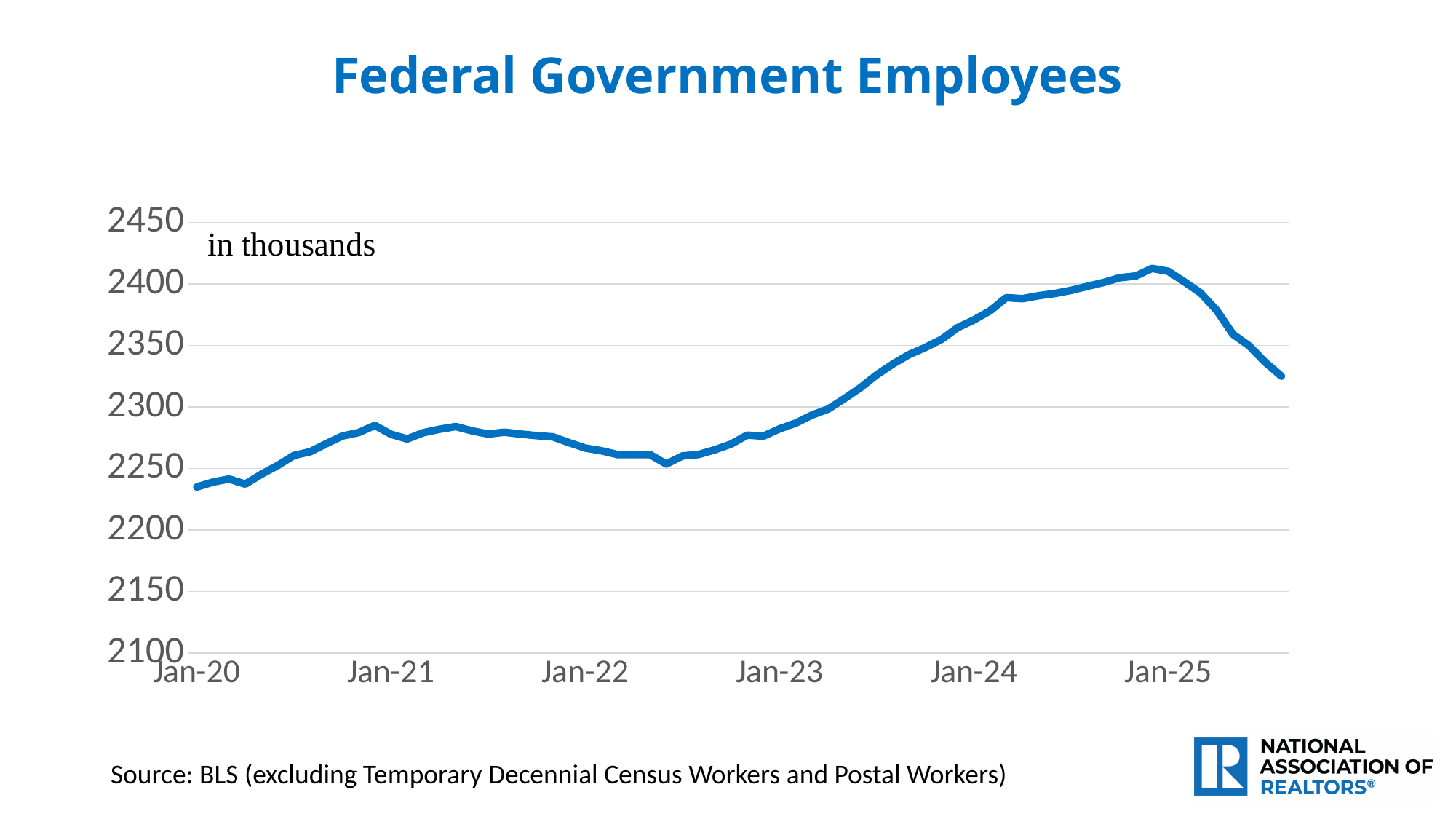
Is the value at Jan-24 greater or less than 2350? greater Is the value at Jan-21 greater or less than 2250? greater Is the value at Jan-22 greater or less than 2300? less Around which labelled year on the x axis does the line reach its highest point? Jan-25 Do the values rise or fall between Jan-23 and Jan-25? rise Which is larger, the value at Jan-24 or the value at Jan-22? Jan-24 What is the title of the chart? Federal Government Employees How many lines are plotted on the chart? 1 What kind of chart is shown on the slide? line chart In what units are the values on the chart expressed? in thousands